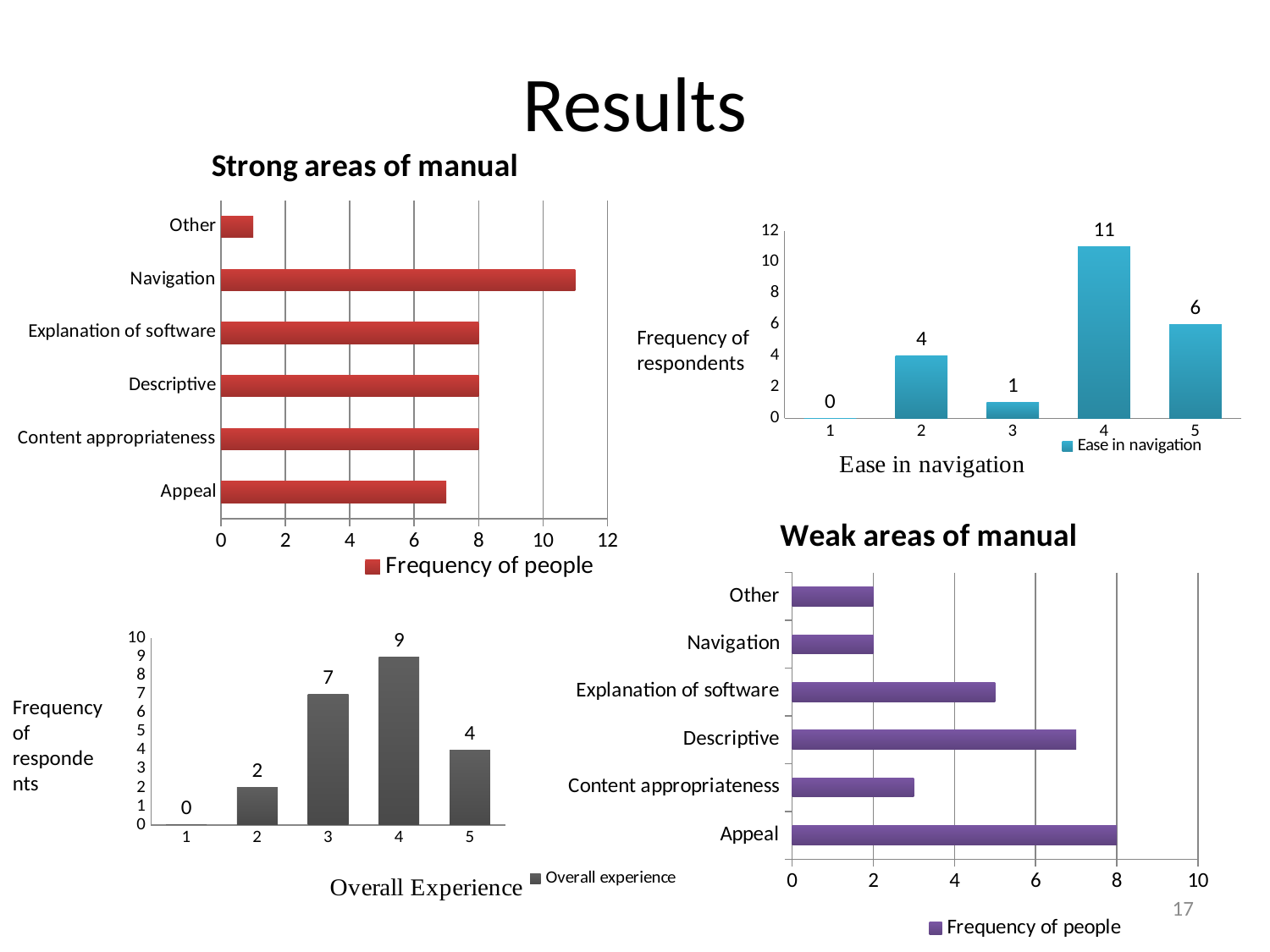
In the 'Ease in navigation' chart, which rating has the lowest frequency of respondents? 1 In the 'Strong areas of manual' chart, what is the frequency of people for 'Descriptive'? 8 In the 'Weak areas of manual' chart, what is the frequency of people for 'Appeal'? 8 In the 'Weak areas of manual' chart, which is larger: the value for 'Descriptive' or the value for 'Content appropriateness'? Descriptive In the 'Ease in navigation' chart, what is the frequency of respondents for rating 4? 11 In the 'Overall Experience' chart, which rating has the highest frequency of respondents? 4 In the 'Overall Experience' chart, what is the frequency of respondents for rating 3? 7 In the 'Overall Experience' chart, what is the total frequency of respondents across all five ratings? 22 In the 'Ease in navigation' chart, what is the difference between the frequencies for rating 4 and rating 5? 5 In the 'Strong areas of manual' chart, is the value for 'Navigation' greater or less than 10? greater How many categories are shown in the 'Weak areas of manual' chart? 6 In the 'Strong areas of manual' chart, which category has the highest frequency of people? Navigation